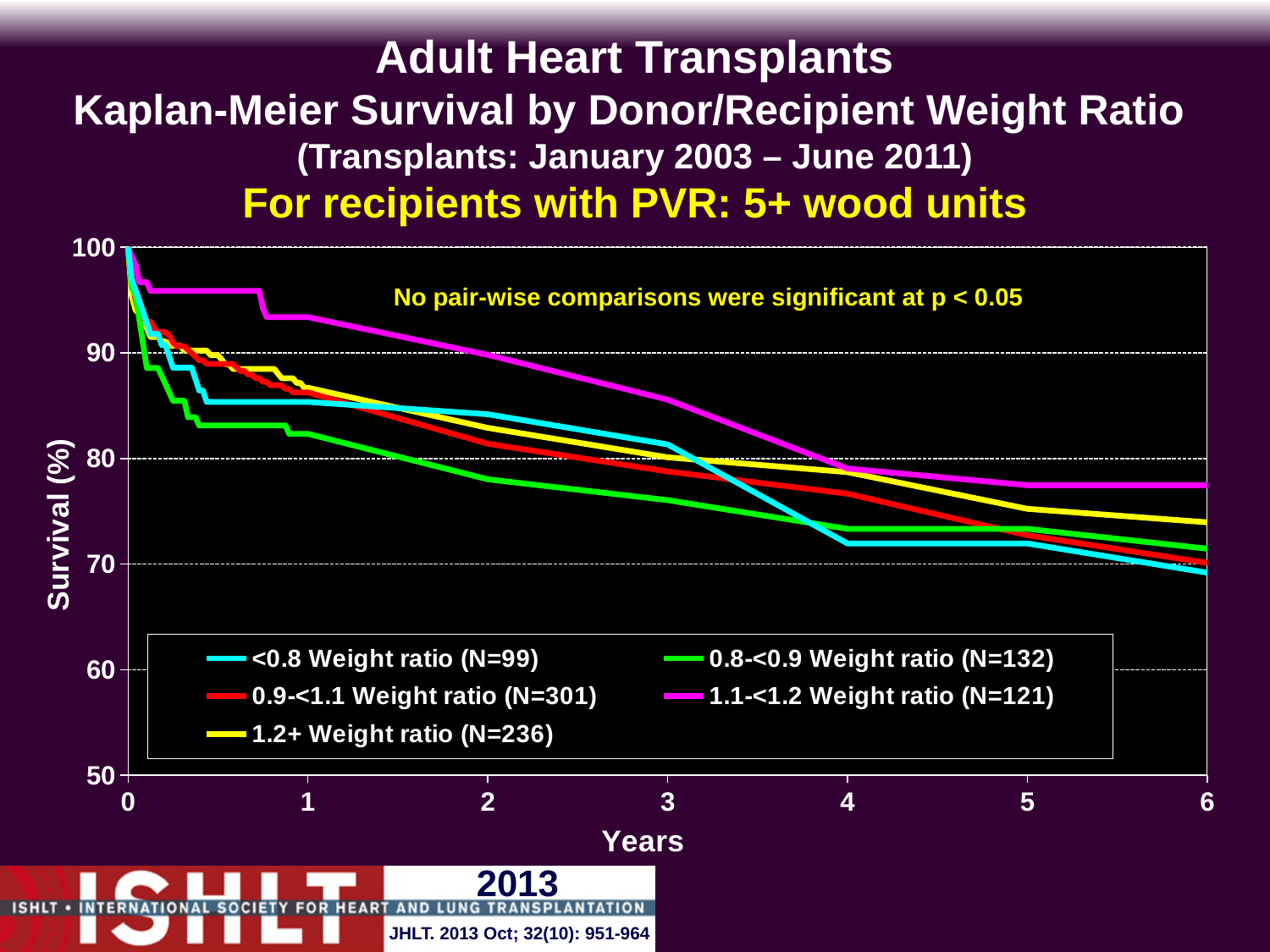
Is the survival for the 1.1-<1.2 weight ratio group at year 6 greater or less than 80? less Do the survival curves rise or fall as years increase? Fall Is the survival for the 1.1-<1.2 weight ratio group at year 3 greater or less than 80? greater What does the annotation inside the plot area say about pair-wise comparisons? No pair-wise comparisons were significant at p < 0.05 Is the survival for the <0.8 weight ratio group at year 6 greater or less than 70? less What is the label of the y-axis? Survival (%) At year 2, which has higher survival: the 1.1-<1.2 weight ratio group or the 0.8-<0.9 weight ratio group? 1.1-<1.2 Weight ratio (N=121) Which weight ratio group has the highest survival at year 3? 1.1-<1.2 Weight ratio (N=121) How many series does the legend list? 5 Which weight ratio group has the highest survival at year 6? 1.1-<1.2 Weight ratio (N=121) Which weight ratio group has the lowest survival at year 2? 0.8-<0.9 Weight ratio (N=132) What kind of chart is shown on the slide? Line chart